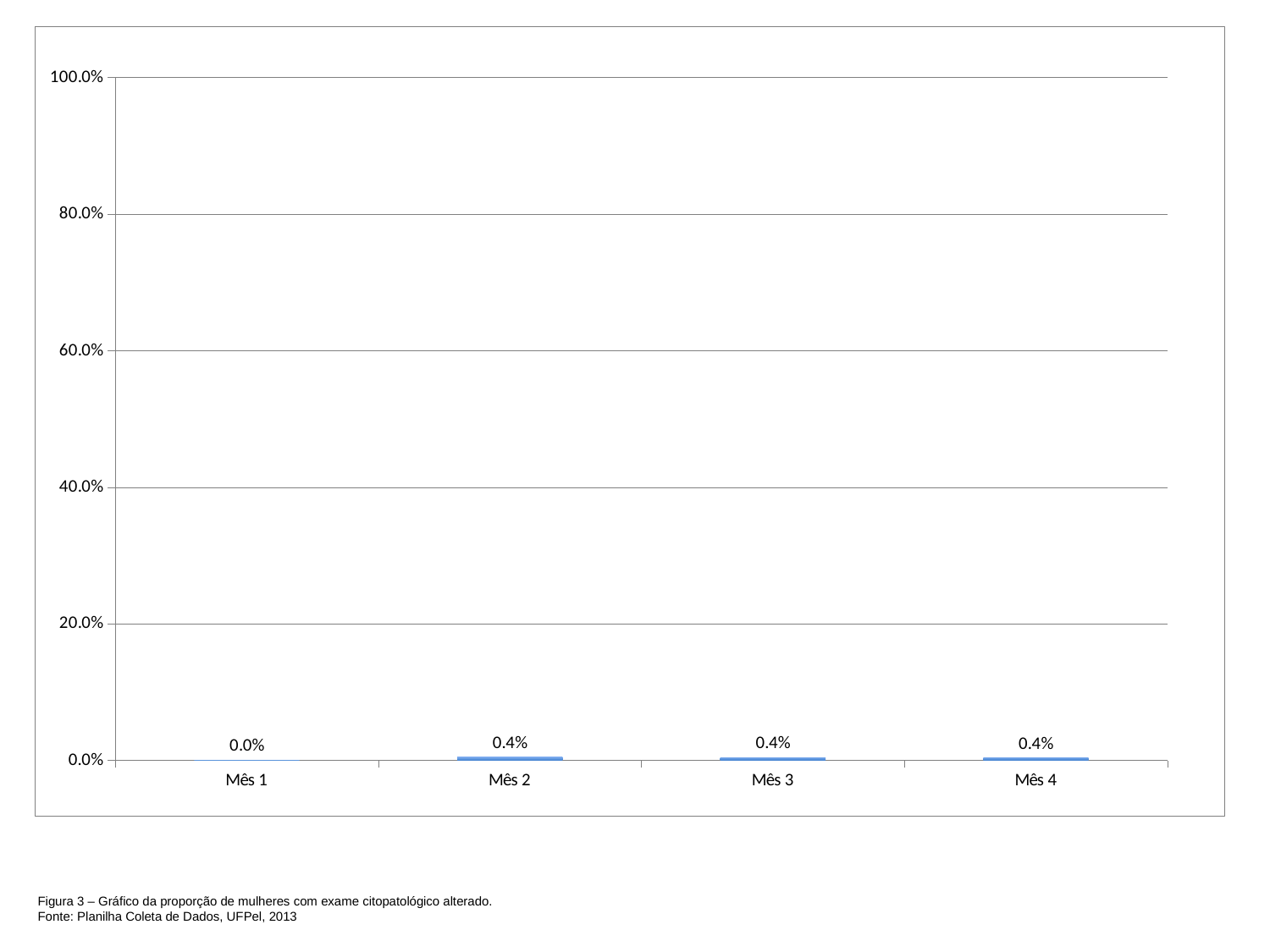
What is the difference between the values for Mês 2 and Mês 1? 0.4% Which is larger, the value for Mês 1 or the value for Mês 4? Mês 4 What is the value for Mês 2? 0.4% According to the caption, what is the source of the data? Planilha Coleta de Dados, UFPel, 2013 How many categories are shown on the x axis? 4 Is the value for Mês 3 greater or less than 20.0%? less Which category has the lowest value? Mês 1 What is the value for Mês 4? 0.4% What is the value for Mês 1? 0.0% What kind of chart is shown on the slide? bar chart What is the highest value shown on the y axis? 100.0% What is the value for Mês 3? 0.4%